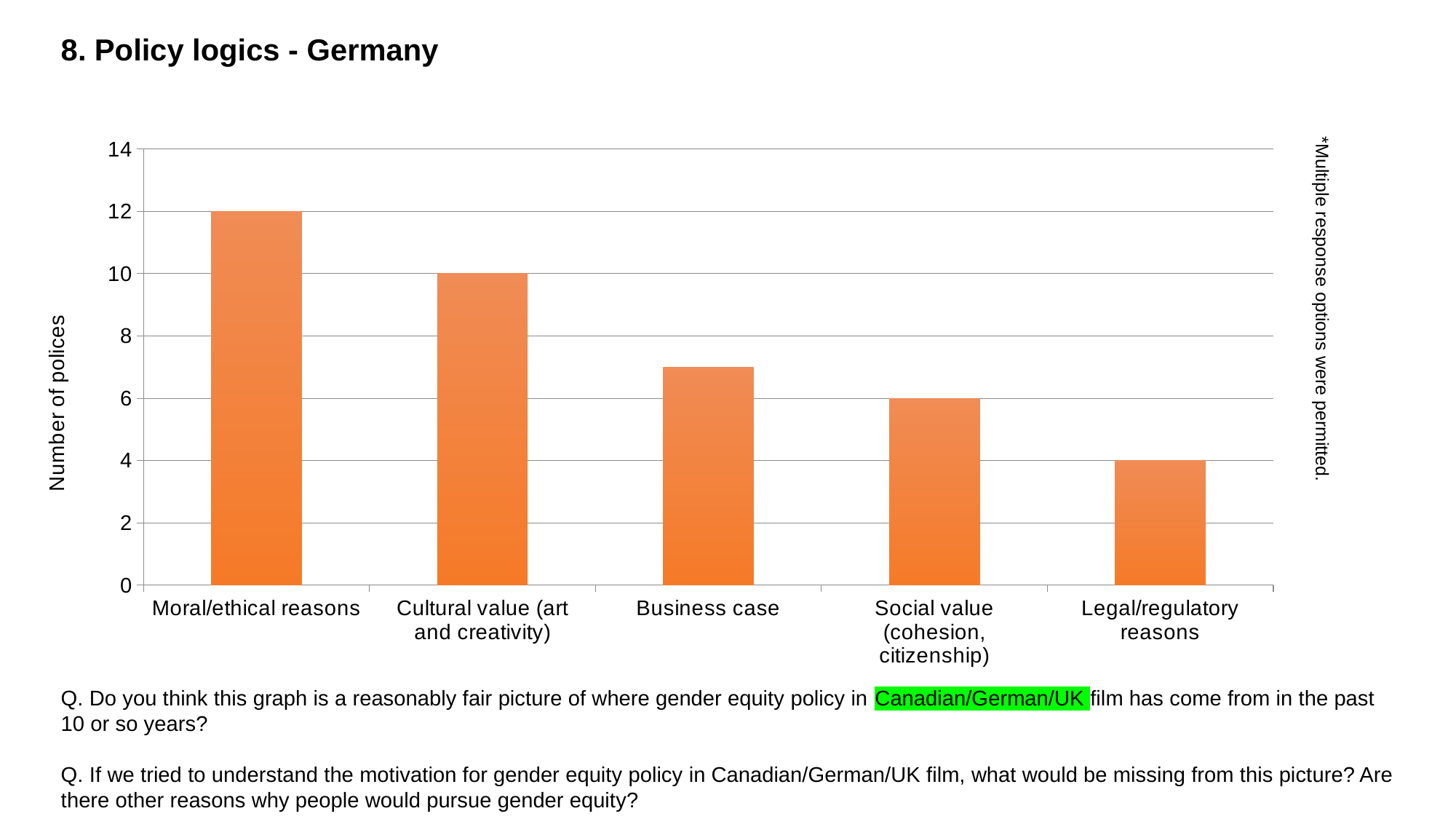
Which category has the lowest value? Legal/regulatory reasons What kind of chart is shown on the slide? Bar chart What is the value for Legal/regulatory reasons? 4 What is the value for Moral/ethical reasons? 12 What is the value for Cultural value (art and creativity)? 10 Is the value for Business case greater or less than 6? greater What is the label of the vertical axis? Number of polices Which is larger, the value for Business case or the value for Social value (cohesion, citizenship)? Business case Which category has the highest value? Moral/ethical reasons What is the difference between the values for Moral/ethical reasons and Cultural value (art and creativity)? 2 What is the value for Social value (cohesion, citizenship)? 6 How many categories are shown on the x axis? 5